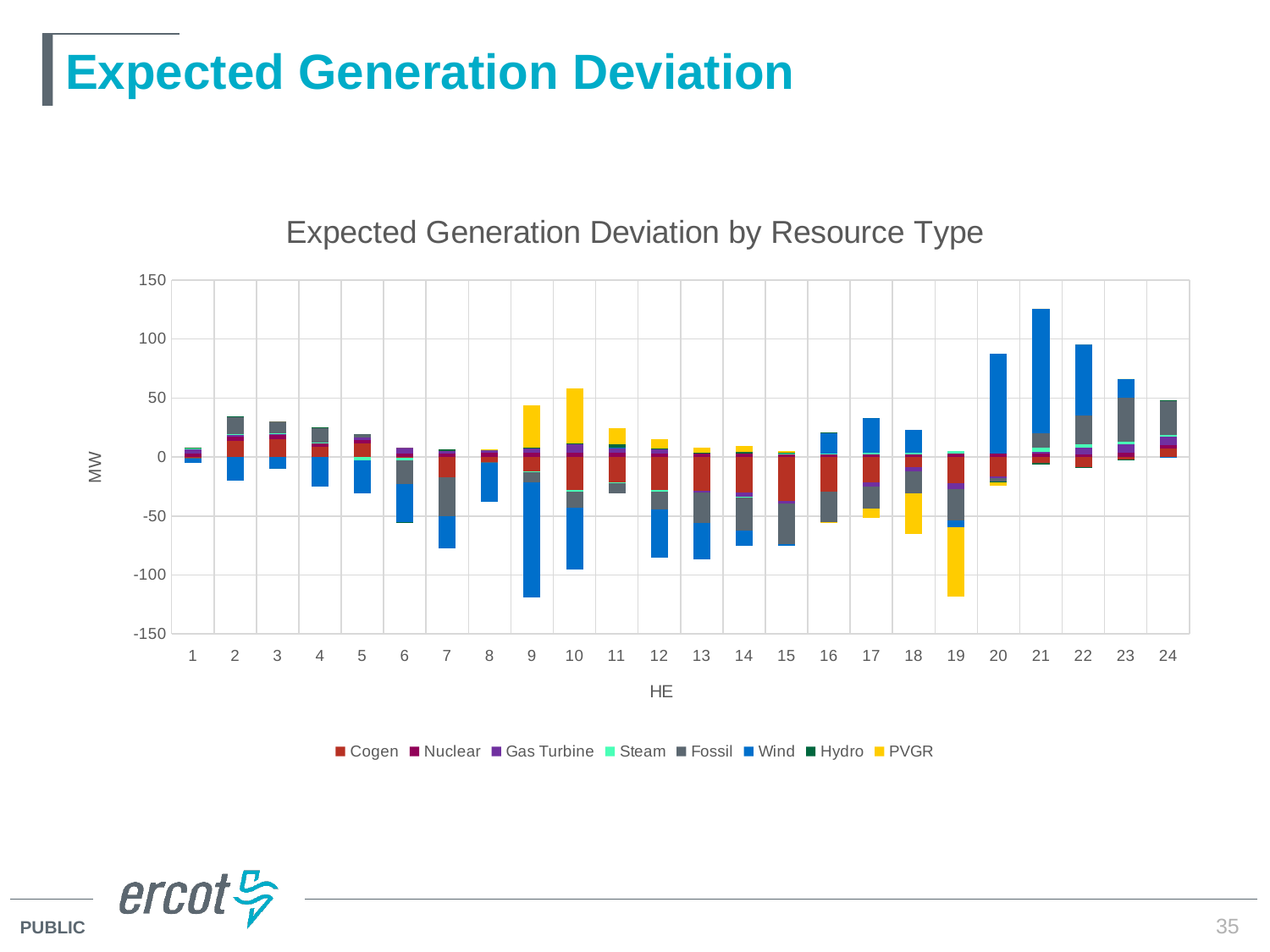
Which has the larger positive stacked bar, HE 20 or HE 21? HE 21 Which HE category has the tallest positive stacked bar? 21 Is the bottom of the stacked bar for HE 19 greater or less than -100? less Is the top of the stacked bar for HE 23 greater or less than 50? greater Is the top of the stacked bar for HE 20 greater or less than 100? less How many hour-ending (HE) categories are plotted along the x axis? 24 How many series does the legend list? 8 What kind of chart is shown on the slide? Stacked bar chart What is the title of the chart? Expected Generation Deviation by Resource Type What is the label of the y axis? MW